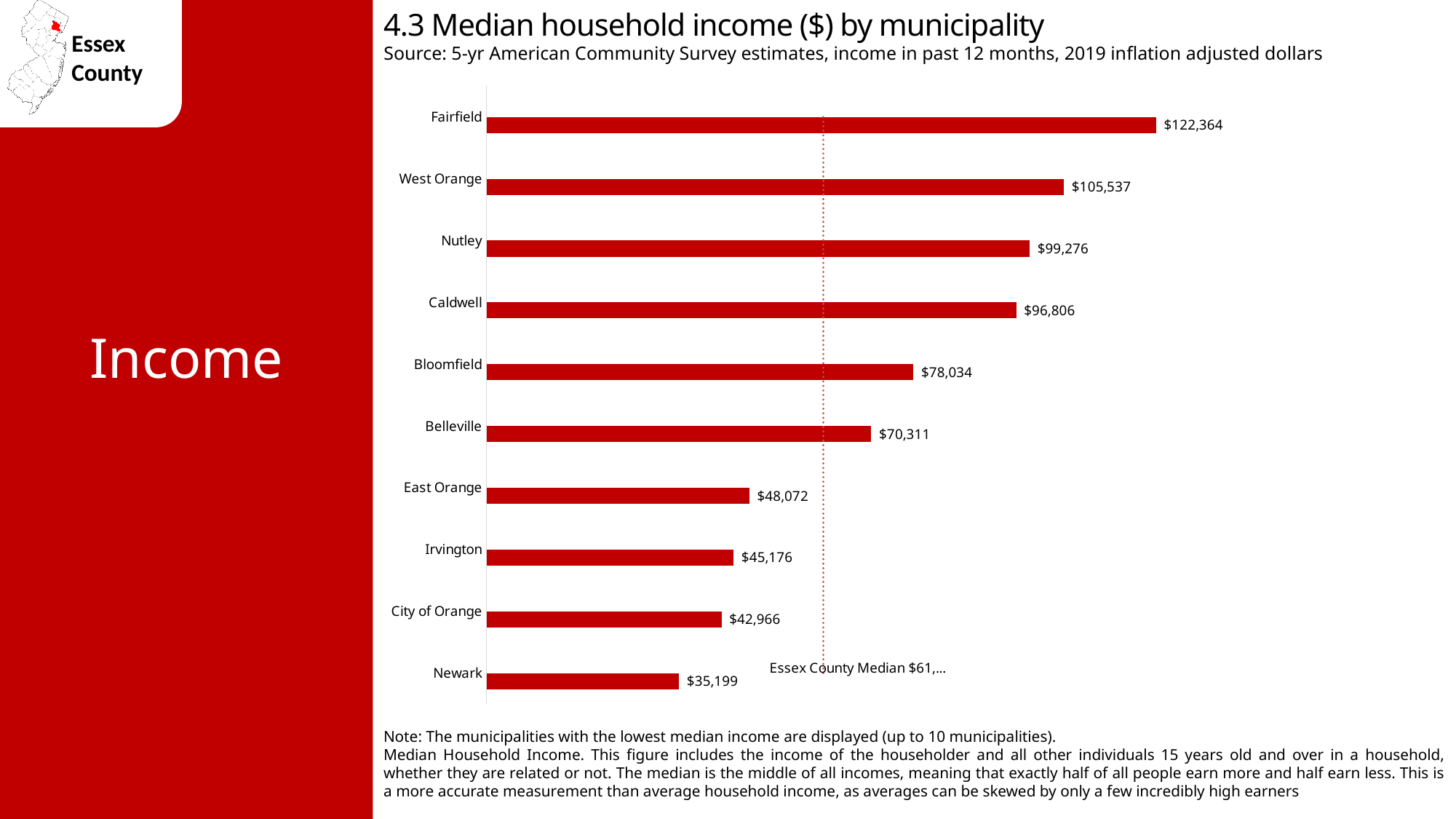
Which municipality has the highest median household income on the chart? Fairfield What is the title of the chart? 4.3 Median household income ($) by municipality What is the median household income for Newark? $35,199 What is the median household income for Irvington? $45,176 What is the median household income for Fairfield? $122,364 What is the difference between the median household income of Fairfield and Newark? $87,165 What is the difference between the median household income of Nutley and Caldwell? $2,470 What is the median household income for Bloomfield? $78,034 What kind of chart is shown on the slide? Bar chart Which has a higher median household income, Belleville or East Orange? Belleville Which municipality has the lowest median household income on the chart? Newark How many municipalities are shown on the chart? 10